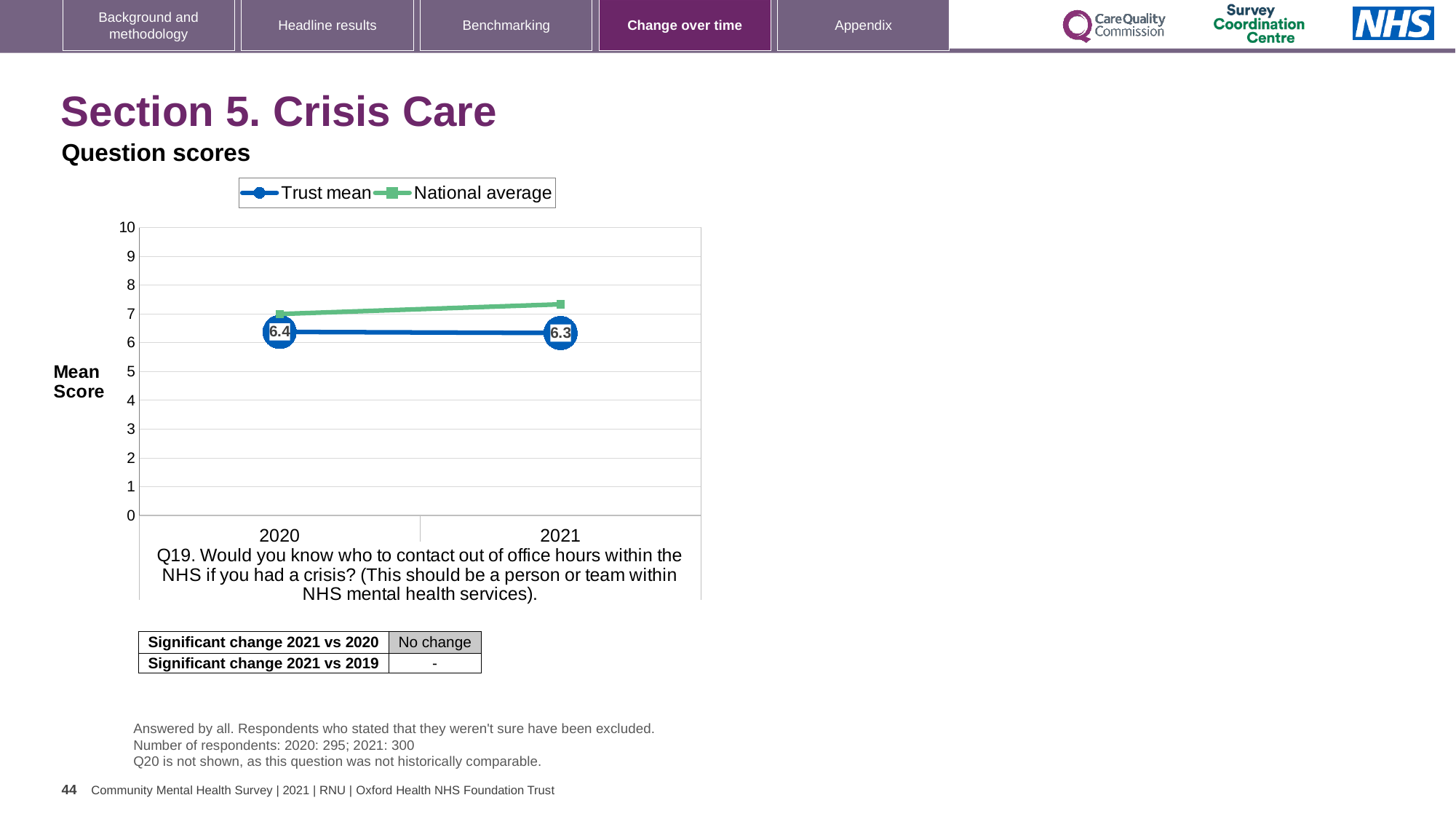
In 2021, which series is higher, the Trust mean or the National average? National average Which year has the higher Trust mean, 2020 or 2021? 2020 What is the difference between the Trust mean in 2020 and in 2021? 0.1 How many series does the chart legend list? 2 Does the Trust mean rise or fall from 2020 to 2021? Fall Is the National average for 2021 greater or less than 8? less What is the Trust mean score for 2020? 6.4 What is the label on the y axis of the chart? Mean Score What is the Trust mean score for 2021? 6.3 What kind of chart is shown on the slide? Line chart Is the National average for 2021 greater or less than 7? greater How many years are shown on the x axis of the chart? 2